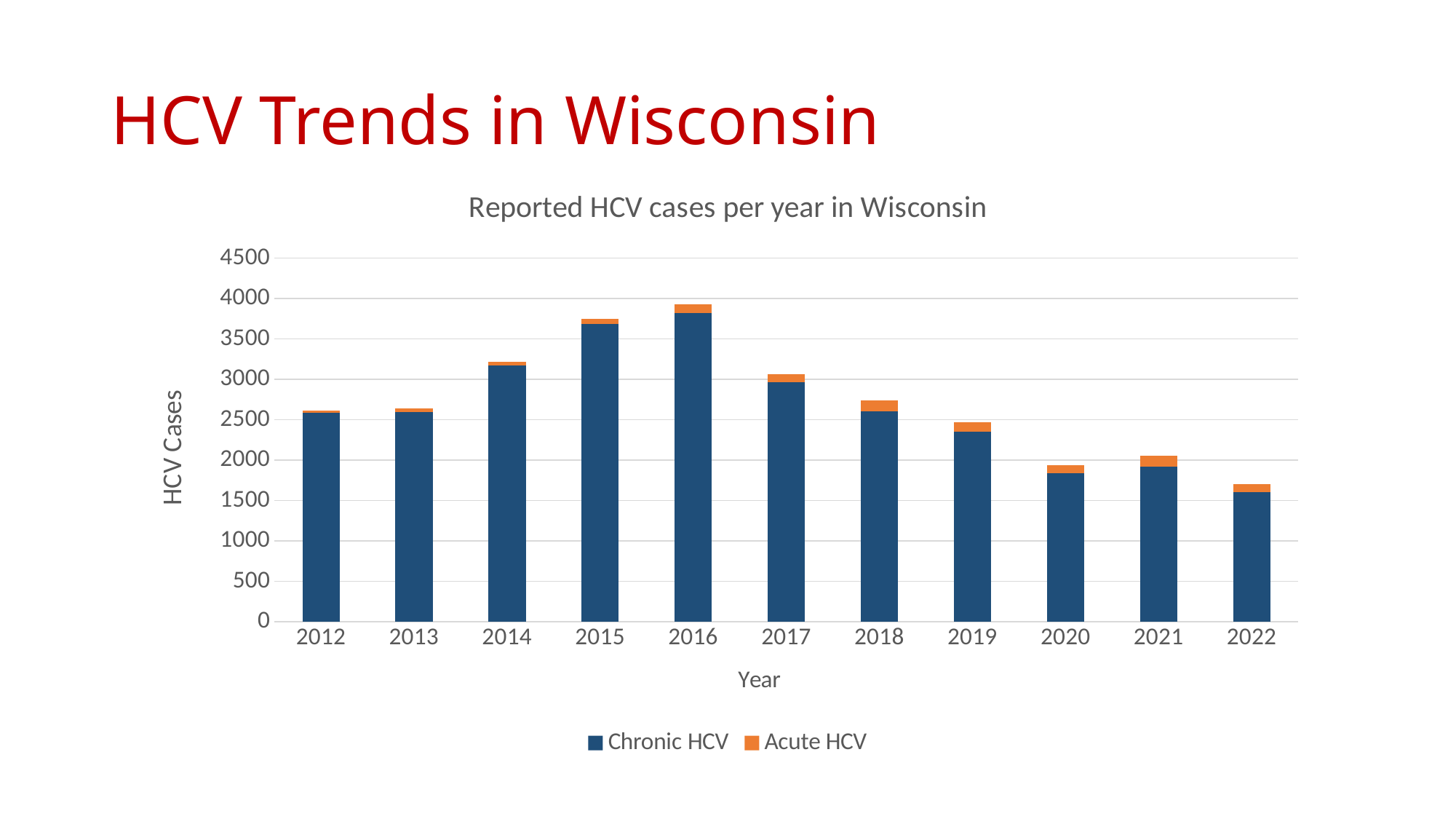
Is the total value for 2016 greater or less than 3500? greater Is the total value for 2018 greater or less than 2500? greater What kind of chart is shown on the slide? bar chart Which series is shown in orange in the legend? Acute HCV Which year has the lowest total of reported HCV cases? 2022 Do the total HCV cases rise or fall from 2016 to 2022? fall How many years are shown on the x axis? 11 Which year has a larger total of HCV cases, 2015 or 2017? 2015 Is the total value for 2022 greater or less than 2000? less Which year has the highest total of reported HCV cases? 2016 How many series does the legend list? 2